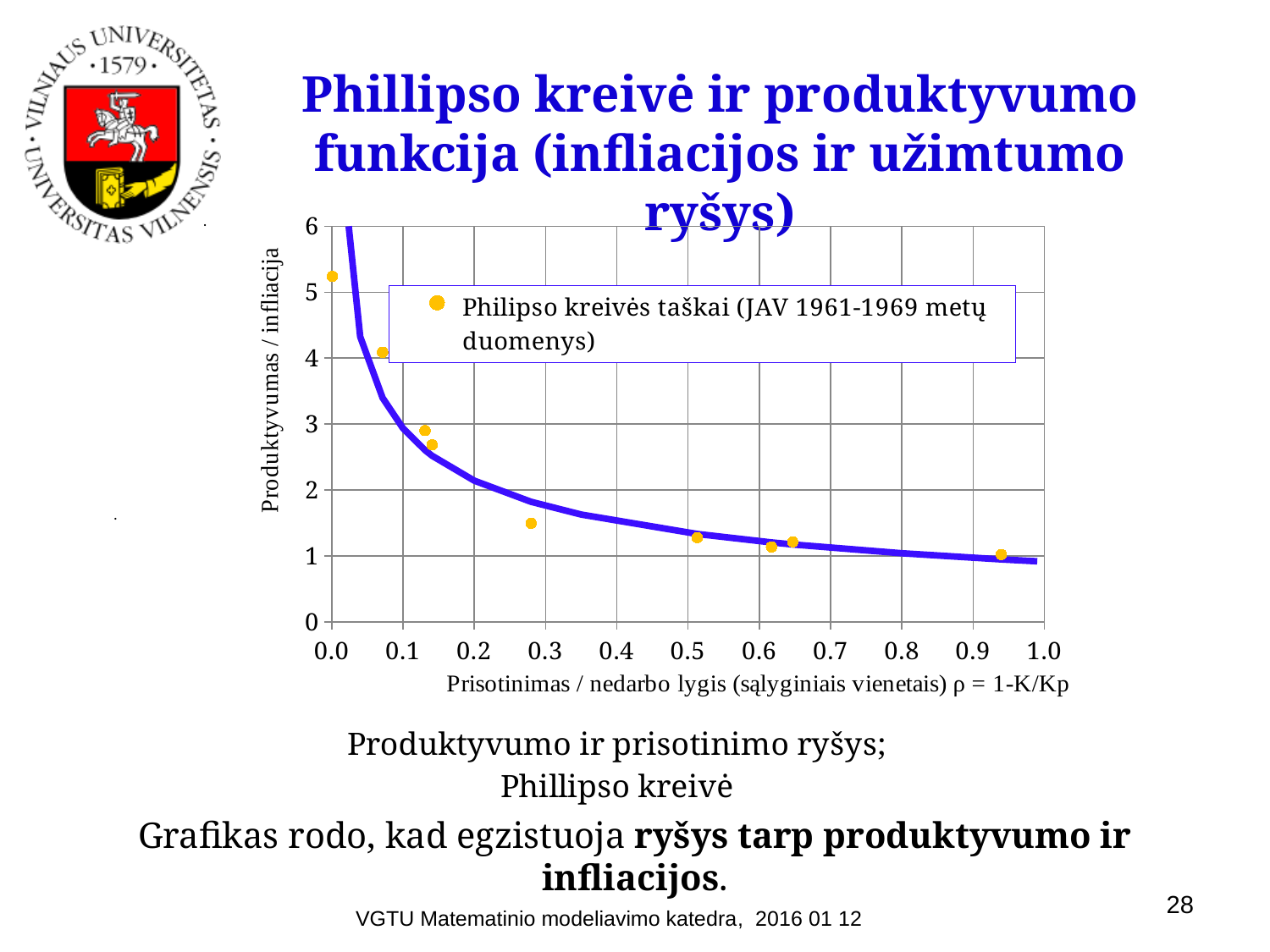
How many series does the legend list? 1 At which x-axis value is the highest plotted point located? 0.0 What is the legend entry for the plotted points? Philipso kreivės taškai (JAV 1961-1969 metų duomenys) Is the value of the point near x = 0.3 greater or less than 2? less Is the value of the point at x = 0.0 greater or less than 4? greater What kind of chart is shown on the slide? scatter chart Is the value of the point near x = 0.9 greater or less than 2? less Do the plotted values rise or fall as the x-axis value increases? fall How many data points are plotted in the chart? 9 What is the maximum value shown on the y-axis? 6 Which point has the larger value: the one near x = 0.1 or the one near x = 0.5? the one near x = 0.1